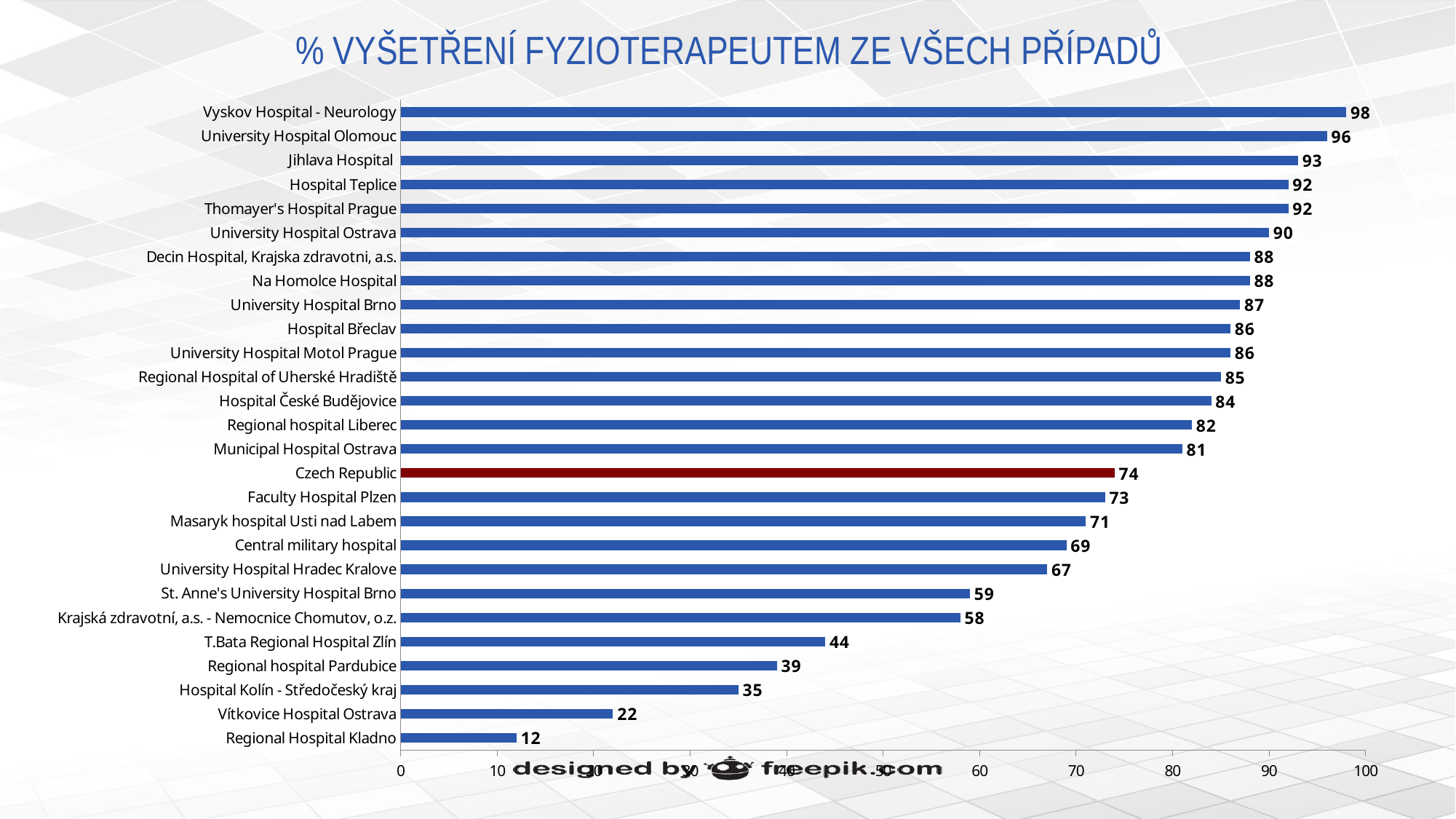
Which category's bar is coloured dark red instead of blue? Czech Republic What is the title of the chart? % VYŠETŘENÍ FYZIOTERAPEUTEM ZE VŠECH PŘÍPADŮ What is the value for Czech Republic? 74 What kind of chart is shown on the slide? bar chart Which category has the highest value? Vyskov Hospital - Neurology Which category has the lowest value? Regional Hospital Kladno Is the value for St. Anne's University Hospital Brno greater or less than 50? greater What is the difference between the values for University Hospital Olomouc and Faculty Hospital Plzen? 23 What is the value for University Hospital Brno? 87 What is the value for Regional Hospital Kladno? 12 How many categories are shown in the chart? 27 Which is larger, the value for T.Bata Regional Hospital Zlín or the value for Regional hospital Pardubice? T.Bata Regional Hospital Zlín